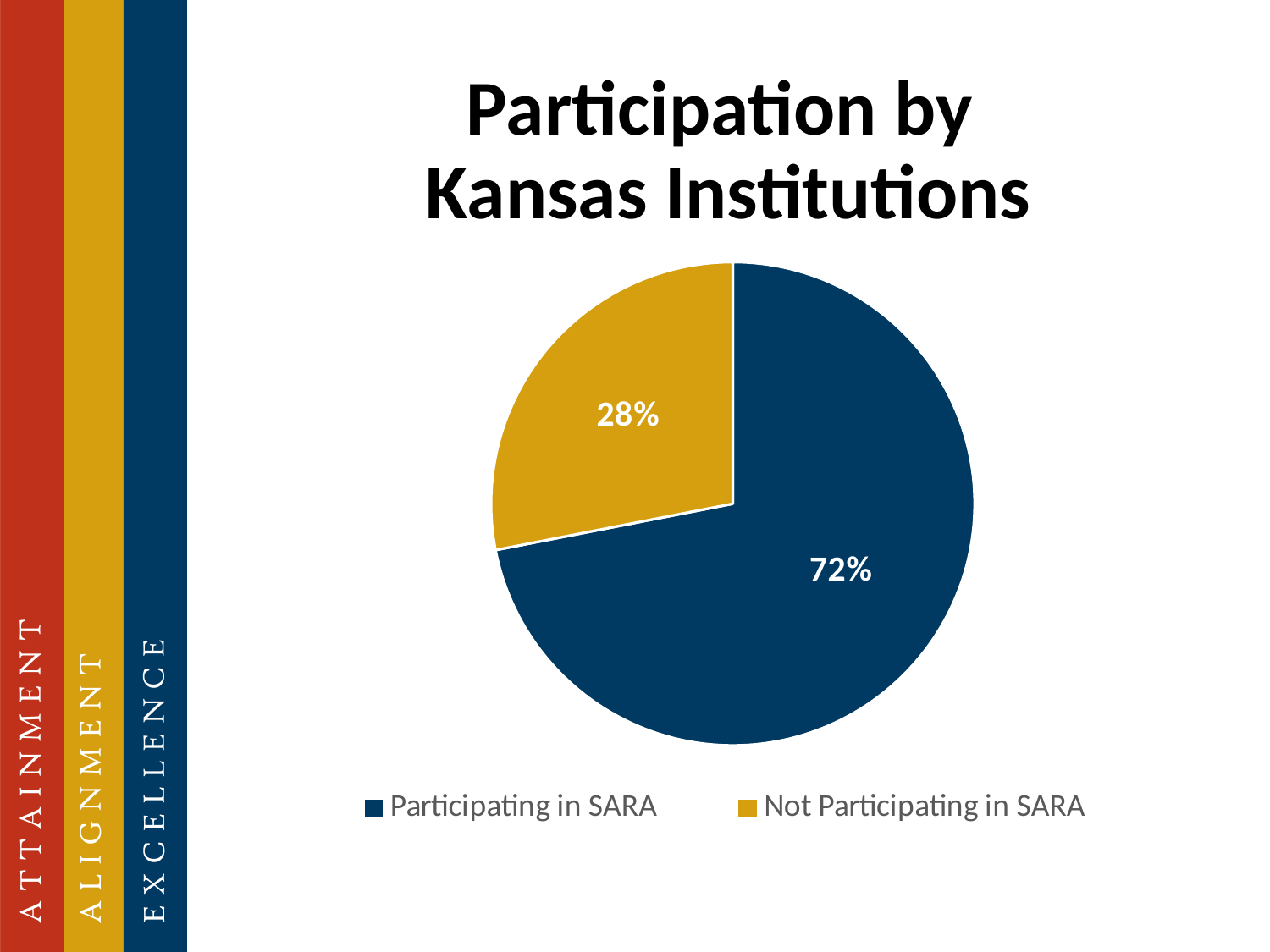
What share of the pie is labelled Not Participating in SARA? 28% How many slices does the pie chart have? 2 What kind of chart is shown on the slide? Pie chart Which slice of the pie is the smallest? Not Participating in SARA What share of the pie is labelled Participating in SARA? 72% How many entries does the legend list? 2 What colour is the Not Participating in SARA slice? Gold Which slice of the pie is the largest? Participating in SARA What is the difference in percentage points between the Participating in SARA slice and the Not Participating in SARA slice? 44 percentage points What is the title of the chart? Participation by Kansas Institutions Which is larger: the Participating in SARA slice or the Not Participating in SARA slice? Participating in SARA